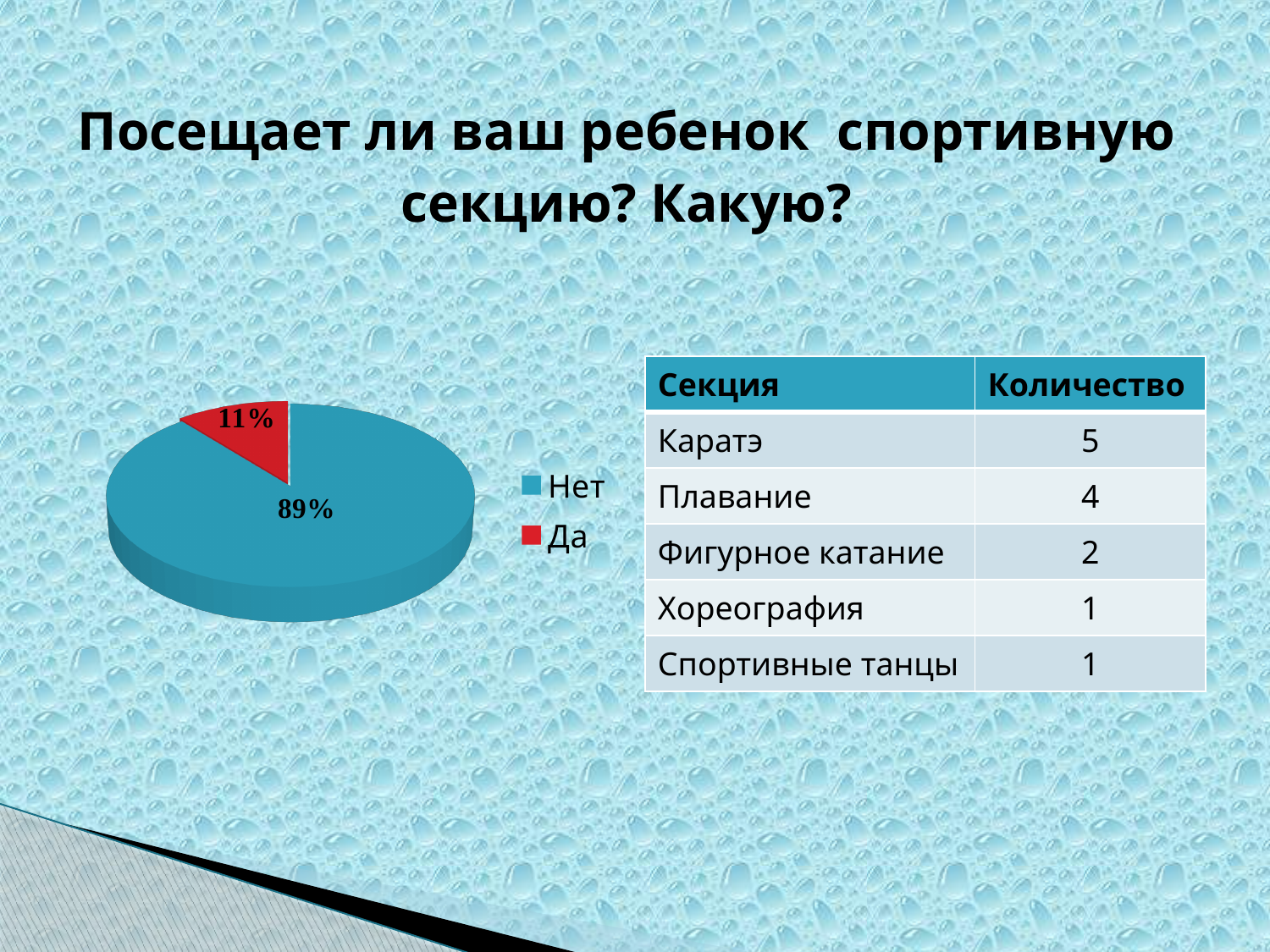
What percentage does the pie chart show for "Да"? 11% How many slices does the pie chart have? 2 By how many percentage points does the "Нет" slice exceed the "Да" slice? 78 percentage points What kind of chart is shown on the slide? pie chart Which slice of the pie chart is the smallest? Да How many entries does the pie chart's legend list? 2 Which slice of the pie chart is the largest? Нет Is the share for "Нет" greater or less than 50%? greater What percentage does the pie chart show for "Нет"? 89% What share of the pie does the "Да" slice represent? 11% What colour is the "Да" slice in the pie chart? red Which is larger in the pie chart, "Нет" or "Да"? Нет